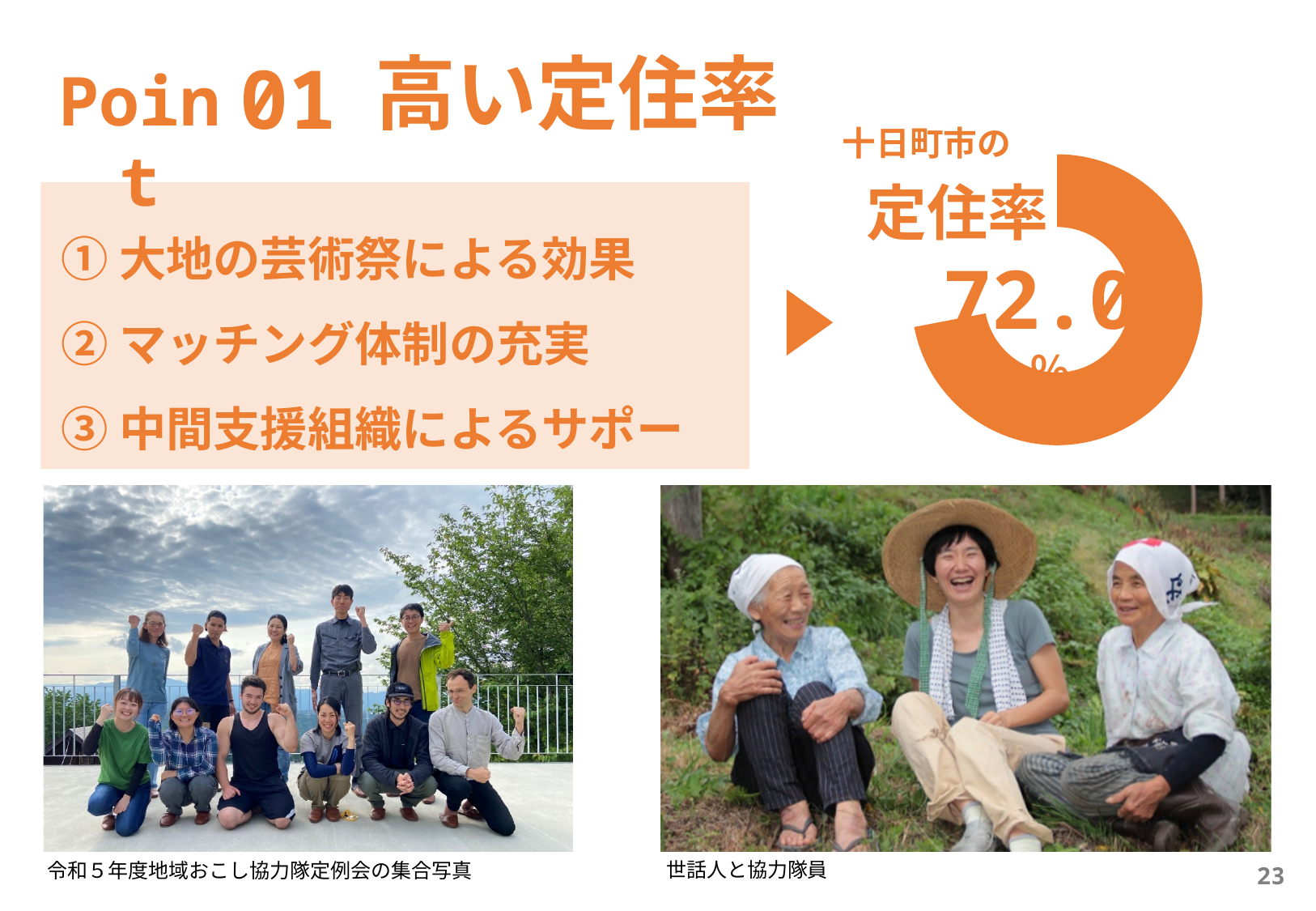
Which city's 定住率 does the doughnut chart represent? 十日町市 Does the filled portion of the doughnut chart cover more or less than half of the ring? more What colour is the filled segment of the doughnut chart? orange What is the 定住率 (settlement rate) for 十日町市 shown in the doughnut chart? 72.0% Is the 定住率 value shown in the doughnut chart greater or less than 50%? greater What kind of chart is shown on the right of the slide next to 十日町市の定住率? doughnut chart